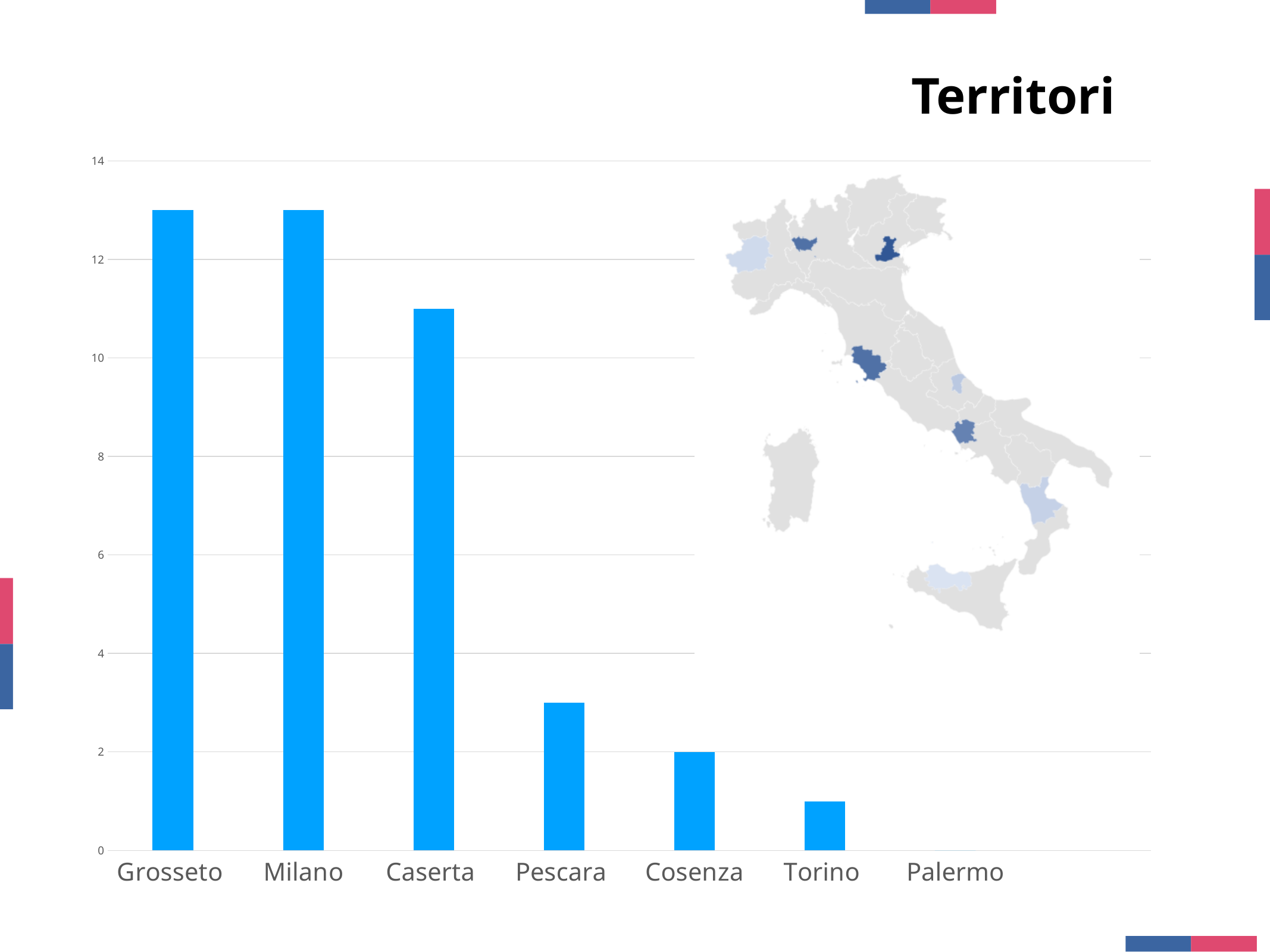
Is the value for Grosseto greater or less than 12? greater Which category has no visible bar in the chart? Palermo Is the value for Pescara greater or less than 4? less Which is larger, the value for Cosenza or the value for Torino? Cosenza Is the value for Torino greater or less than 2? less Do the values rise or fall from left to right along the x axis? fall What kind of chart is shown on the slide? bar chart How many categories are shown on the x axis of the chart? 7 What is the title of the slide? Territori What is the value for Cosenza? 2 Which is larger, the value for Caserta or the value for Pescara? Caserta